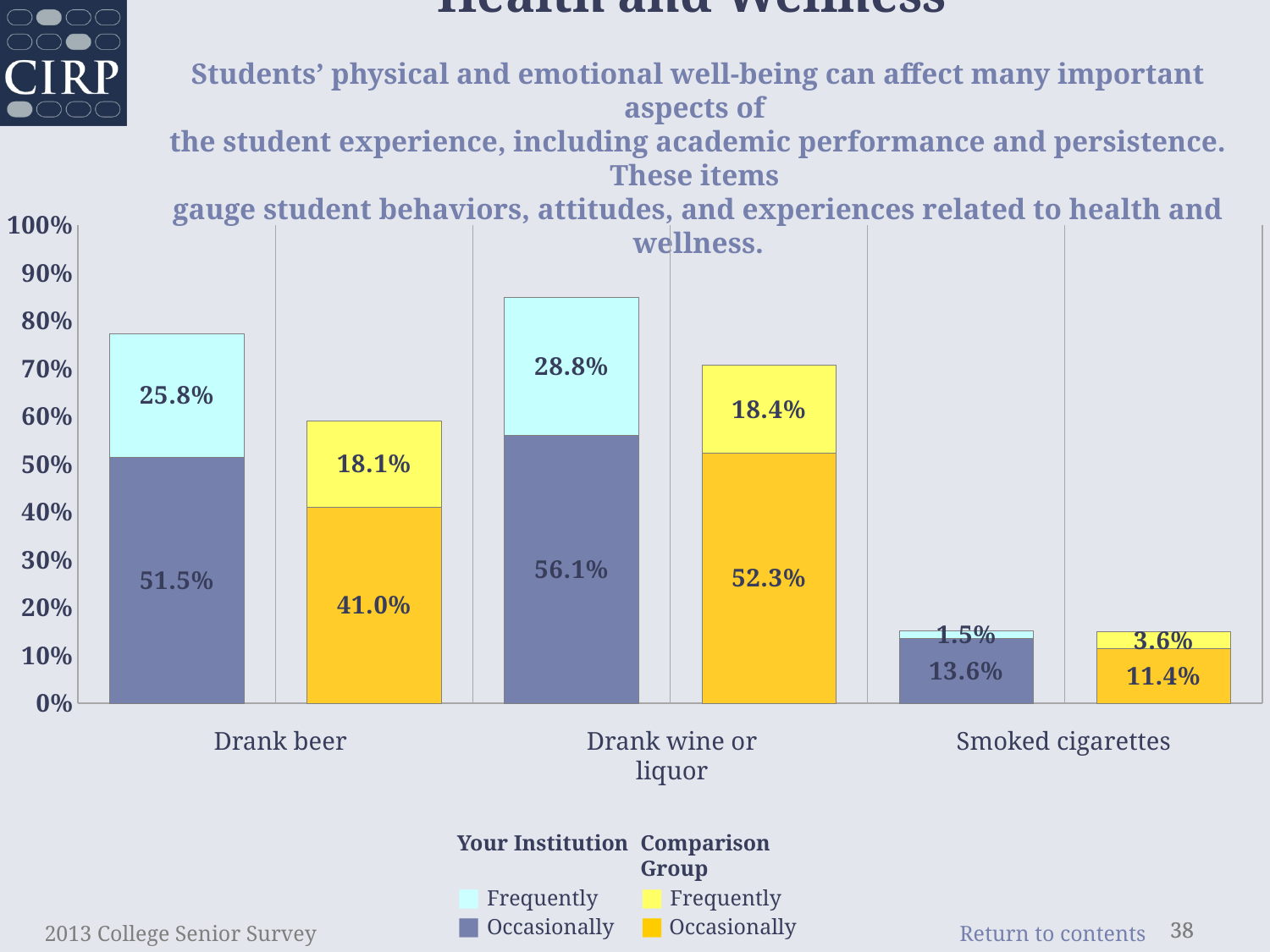
What percentage of Your Institution students reported drinking beer occasionally? 51.5% What is the total height of the Your Institution stacked bar for Drank beer? 77.3% What is the total height of the Comparison Group stacked bar for Drank wine or liquor? 70.7% For Drank wine or liquor, which is larger: Your Institution's 'Frequently' value or the Comparison Group's 'Frequently' value? Your Institution What percentage of Your Institution students reported smoking cigarettes frequently? 1.5% Which category has the lowest 'Frequently' value for the Comparison Group? Smoked cigarettes Which category has the highest 'Occasionally' value for Your Institution? Drank wine or liquor What is the difference between Your Institution's and the Comparison Group's 'Occasionally' values for Drank beer? 10.5% What is the Comparison Group's 'Frequently' value for Drank wine or liquor? 18.4% What is the Comparison Group's 'Occasionally' value for Smoked cigarettes? 11.4% How many categories are shown on the x axis of the chart? 3 What kind of chart is shown on the slide? Stacked bar chart